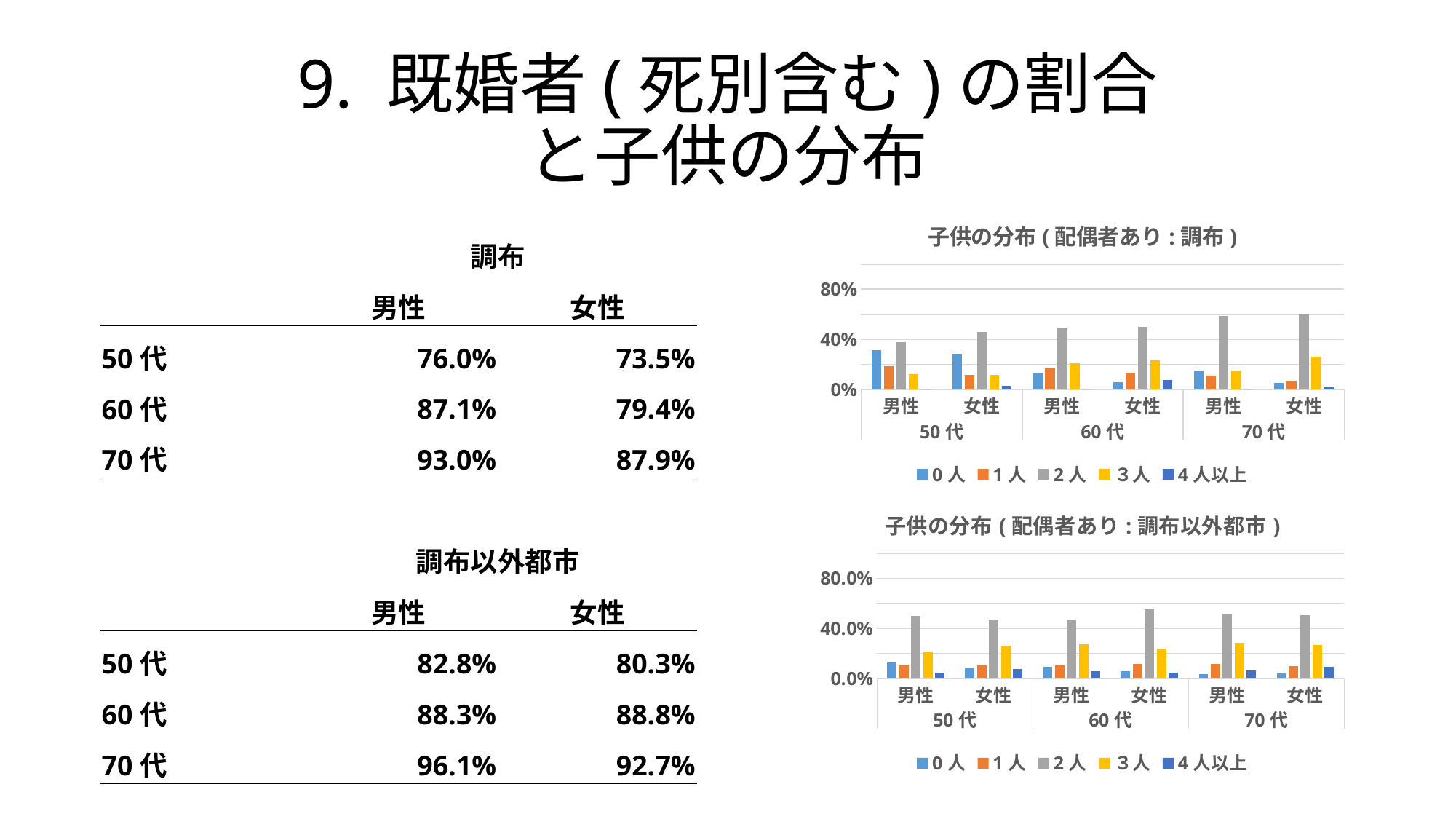
In the chart titled 子供の分布(配偶者あり:調布), which series has the lowest value for 70代 女性? 4人以上 In the chart titled 子供の分布(配偶者あり:調布), is the value of 2人 for 70代 女性 greater or less than 40%? greater What kind of chart is the chart titled 子供の分布(配偶者あり:調布)? bar chart In the chart titled 子供の分布(配偶者あり:調布), which series has the highest value for 70代 女性? 2人 In the chart titled 子供の分布(配偶者あり:調布以外都市), which is larger for 70代 男性: 3人 or 1人? 3人 In the chart titled 子供の分布(配偶者あり:調布), is the value of 0人 for 50代 男性 greater or less than 40%? less In the chart titled 子供の分布(配偶者あり:調布), which is larger for 50代 男性: 0人 or 1人? 0人 In the chart titled 子供の分布(配偶者あり:調布), how many category groups (gender within age group) are shown on the x axis? 6 In the chart titled 子供の分布(配偶者あり:調布以外都市), which series has the highest value for 60代 女性? 2人 In the chart titled 子供の分布(配偶者あり:調布以外都市), is the value of 2人 for 60代 女性 greater or less than 40.0%? greater How many series does the legend of the chart titled 子供の分布(配偶者あり:調布以外都市) list? 5 In the chart titled 子供の分布(配偶者あり:調布以外都市), what is the highest value shown on the vertical axis? 80.0%